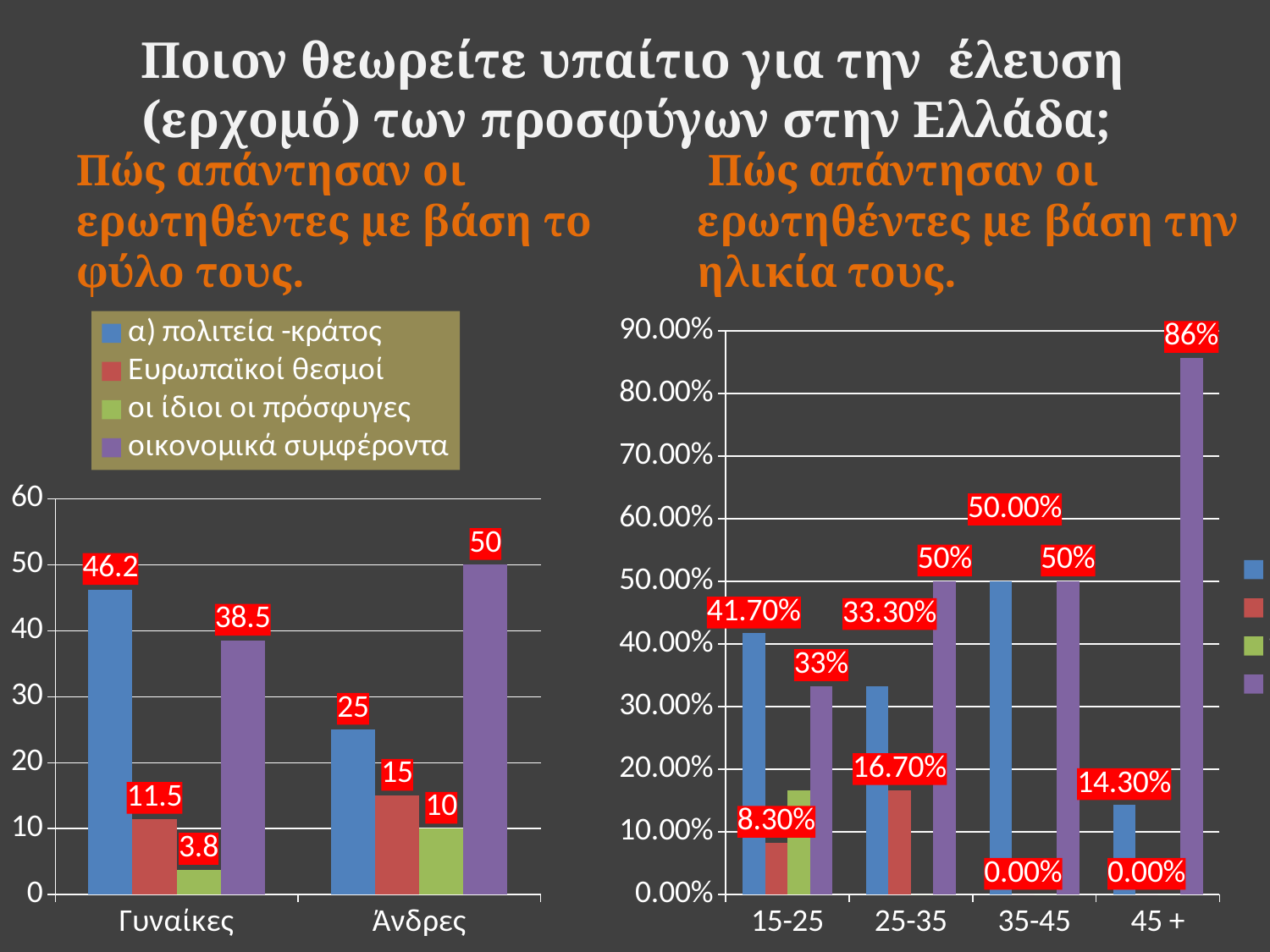
On the right chart (by age), how many age categories are shown on the x axis? 4 On the right chart (by age), what is the value of the purple bar for 45 +? 86% On the left chart (by gender), which is larger: οικονομικά συμφέροντα for Γυναίκες or α) πολιτεία -κράτος for Άνδρες? οικονομικά συμφέροντα for Γυναίκες On the left chart (by gender), how many series does the legend list? 4 On the left chart (by gender), what is the value for οικονομικά συμφέροντα for Άνδρες? 50 On the left chart (by gender), what is the difference between the Ευρωπαϊκοί θεσμοί values for Άνδρες and Γυναίκες? 3.5 On the right chart (by age), what is the value of the blue bar for 15-25? 41.70% On the right chart (by age), is the green bar for 15-25 greater or less than 20.00%? less What kind of chart is the right chart (by age)? Bar chart On the left chart (by gender), what is the value for α) πολιτεία -κράτος for Γυναίκες? 46.2 On the right chart (by age), do the values of the blue bars rise or fall from 25-35 to 45 +? They rise then fall On the left chart (by gender), which series has the lowest value for Γυναίκες? οι ίδιοι οι πρόσφυγες